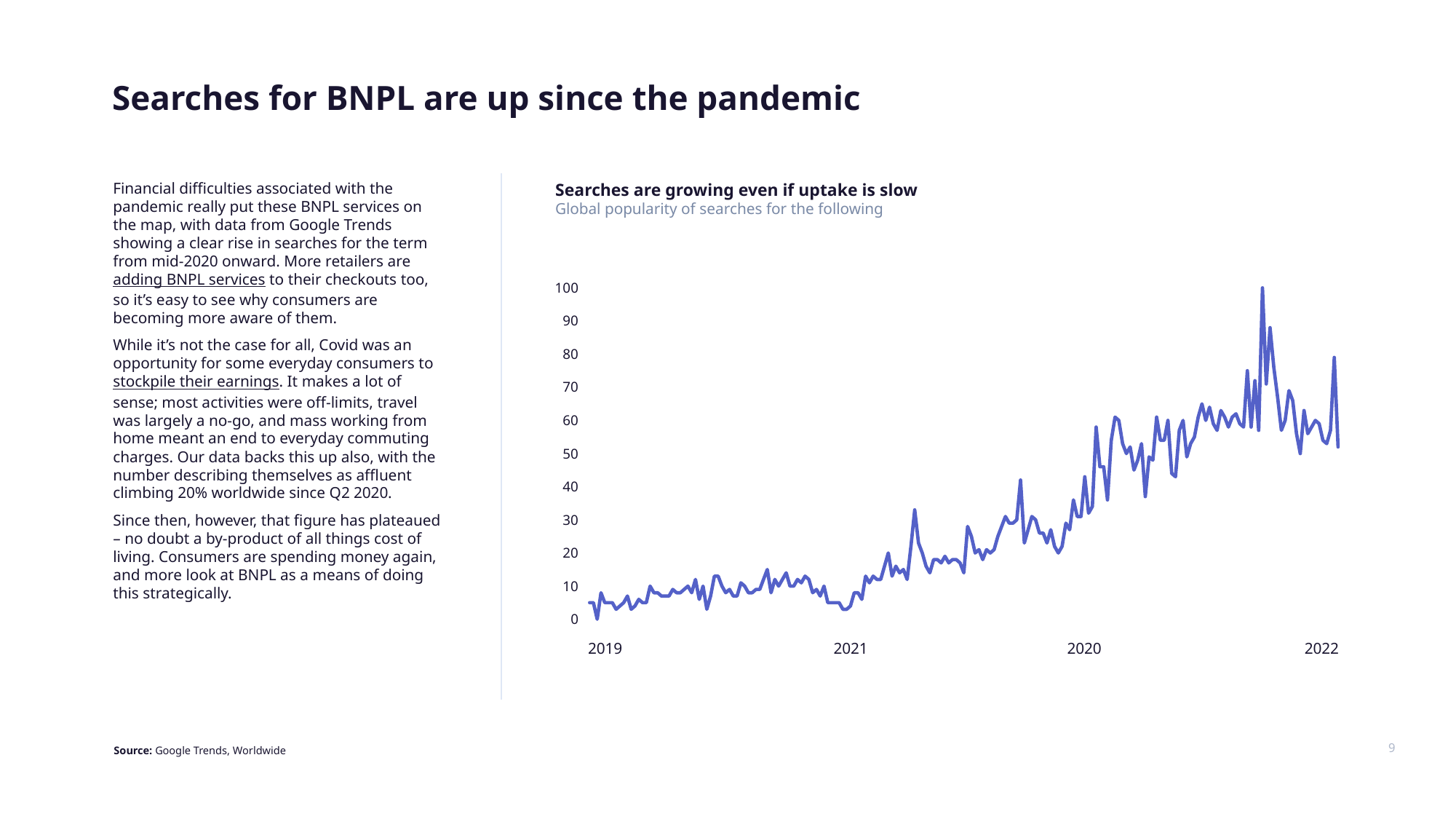
Overall, do the values rise or fall from left to right along the x axis? rise Is the value at the 2020 label on the x axis greater or less than 20? greater How many year labels are shown along the x axis? 4 Is the value at the far right end of the line, near the 2022 label, greater or less than 40? greater Is the value at the start of the line, at the 2019 label, greater or less than 10? less What is the highest value shown on the y axis? 100 What kind of chart is shown on the slide? line chart What is the title of the chart? Searches are growing even if uptake is slow Is the value near the 2022 label larger or smaller than the value near the 2019 label? larger What is the subtitle printed under the chart title? Global popularity of searches for the following